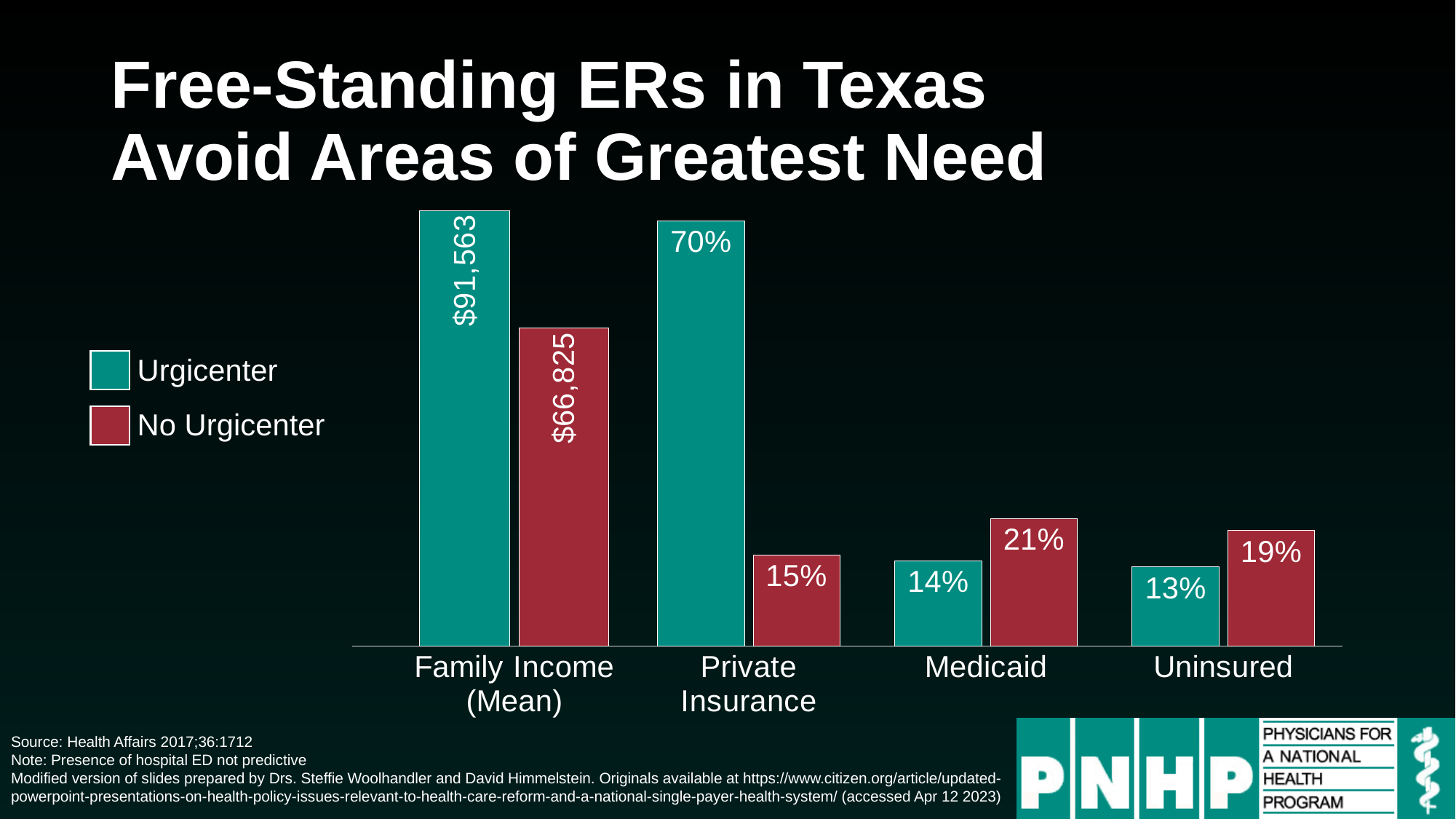
What is the Uninsured value for the Urgicenter series? 13% What is the mean family income for the Urgicenter series? $91,563 What is the difference between the Urgicenter and No Urgicenter values for Private Insurance? 55% What kind of chart is shown on the slide? Bar chart What is the mean family income for the No Urgicenter series? $66,825 How many categories are shown on the x axis? 4 How many series does the legend list? 2 Which series has the larger Medicaid value, Urgicenter or No Urgicenter? No Urgicenter What is the Private Insurance value for the Urgicenter series? 70% What is the Medicaid value for the No Urgicenter series? 21% Which series has the larger mean family income, Urgicenter or No Urgicenter? Urgicenter What is the difference between the No Urgicenter and Urgicenter values for Uninsured? 6%